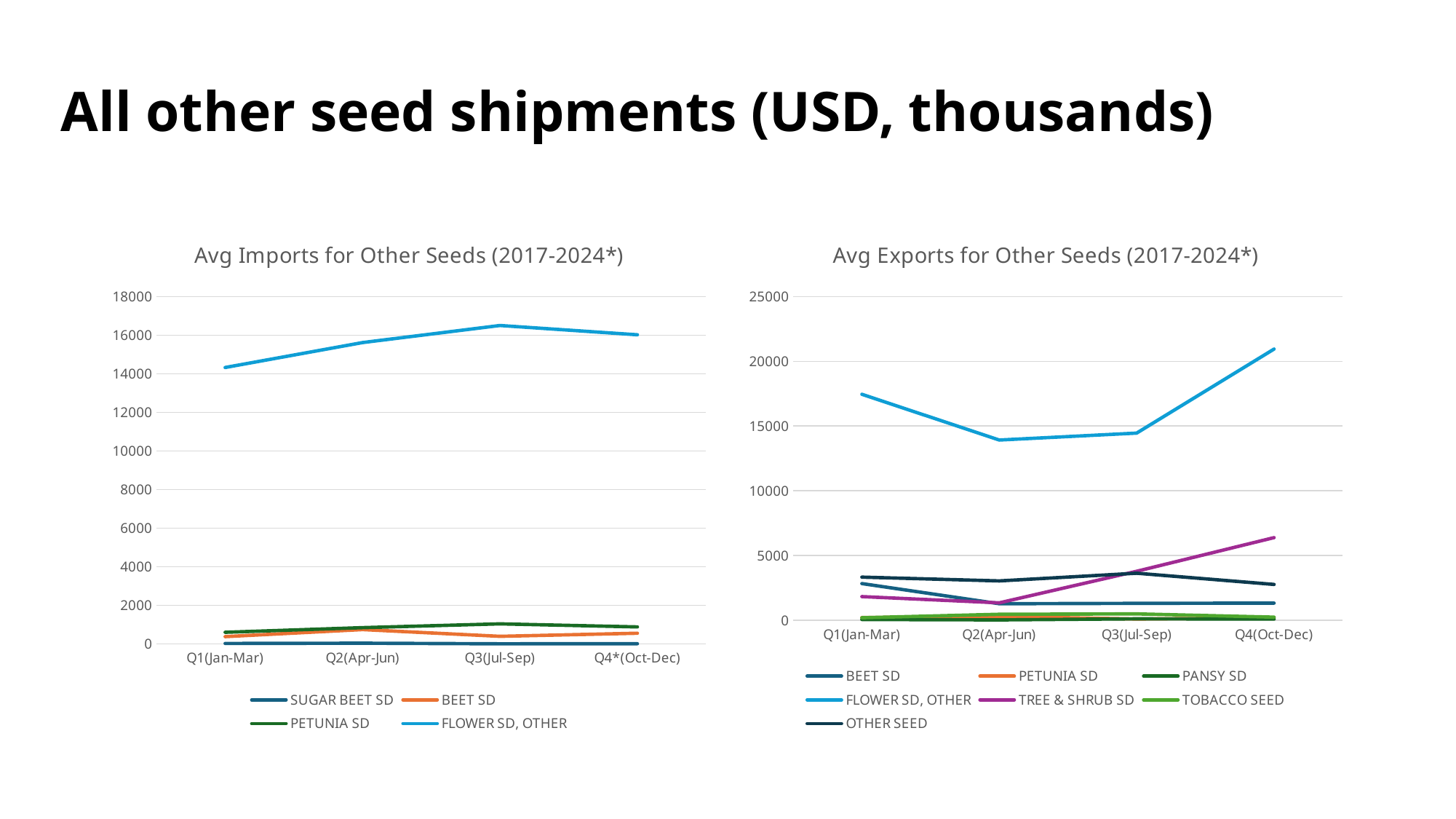
In the 'Avg Exports for Other Seeds (2017-2024*)' chart, in which quarter is FLOWER SD, OTHER lowest? Q2(Apr-Jun) How many series does the legend of the 'Avg Exports for Other Seeds (2017-2024*)' chart list? 7 In the 'Avg Exports for Other Seeds (2017-2024*)' chart, is the value for TREE & SHRUB SD in Q4(Oct-Dec) greater or less than 5000? greater In the 'Avg Imports for Other Seeds (2017-2024*)' chart, in which quarter is FLOWER SD, OTHER highest? Q3(Jul-Sep) How many series does the legend of the 'Avg Imports for Other Seeds (2017-2024*)' chart list? 4 In the 'Avg Imports for Other Seeds (2017-2024*)' chart, is the value for FLOWER SD, OTHER in Q3(Jul-Sep) greater or less than 16000? greater In the 'Avg Exports for Other Seeds (2017-2024*)' chart, is the value for FLOWER SD, OTHER in Q4(Oct-Dec) greater or less than 20000? greater What kind of chart is the 'Avg Imports for Other Seeds (2017-2024*)' chart on the left? Line chart In the 'Avg Exports for Other Seeds (2017-2024*)' chart, does TREE & SHRUB SD rise or fall from Q2(Apr-Jun) to Q4(Oct-Dec)? Rise In the 'Avg Exports for Other Seeds (2017-2024*)' chart, in which quarter is FLOWER SD, OTHER highest? Q4(Oct-Dec) How many quarters are shown on the x axis of the 'Avg Imports for Other Seeds (2017-2024*)' chart? 4 In the 'Avg Exports for Other Seeds (2017-2024*)' chart, which is larger in Q4(Oct-Dec): TREE & SHRUB SD or OTHER SEED? TREE & SHRUB SD